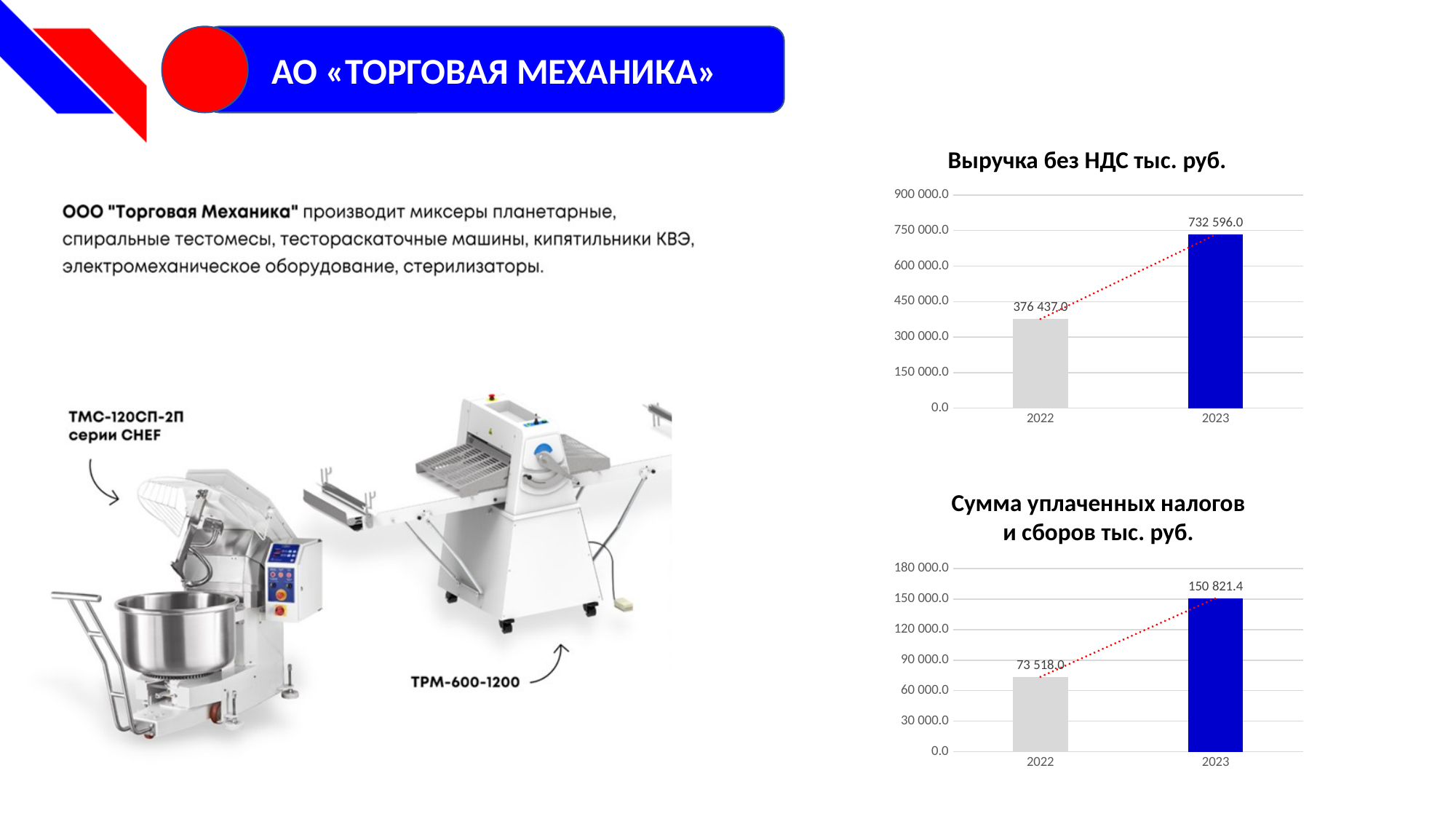
In the chart titled "Выручка без НДС тыс. руб.", what is the difference between the 2023 and 2022 values? 356 159.0 In the chart titled "Выручка без НДС тыс. руб.", is the value for 2022 greater or less than 450 000.0? less In the chart titled "Сумма уплаченных налогов и сборов тыс. руб.", what is the difference between the 2023 and 2022 values? 77 303.4 In the chart titled "Выручка без НДС тыс. руб.", what is the value for 2022? 376 437.0 What kind of chart is the chart titled "Выручка без НДС тыс. руб."? Bar chart How many years are shown on the x axis of the chart titled "Сумма уплаченных налогов и сборов тыс. руб."? 2 In the chart titled "Сумма уплаченных налогов и сборов тыс. руб.", which year has the lowest value? 2022 In the chart titled "Сумма уплаченных налогов и сборов тыс. руб.", what is the value for 2023? 150 821.4 In the chart titled "Сумма уплаченных налогов и сборов тыс. руб.", what is the value for 2022? 73 518.0 In the chart titled "Сумма уплаченных налогов и сборов тыс. руб.", do the values rise or fall from 2022 to 2023? Rise In the chart titled "Выручка без НДС тыс. руб.", which year has the highest value? 2023 In the chart titled "Выручка без НДС тыс. руб.", what is the value for 2023? 732 596.0